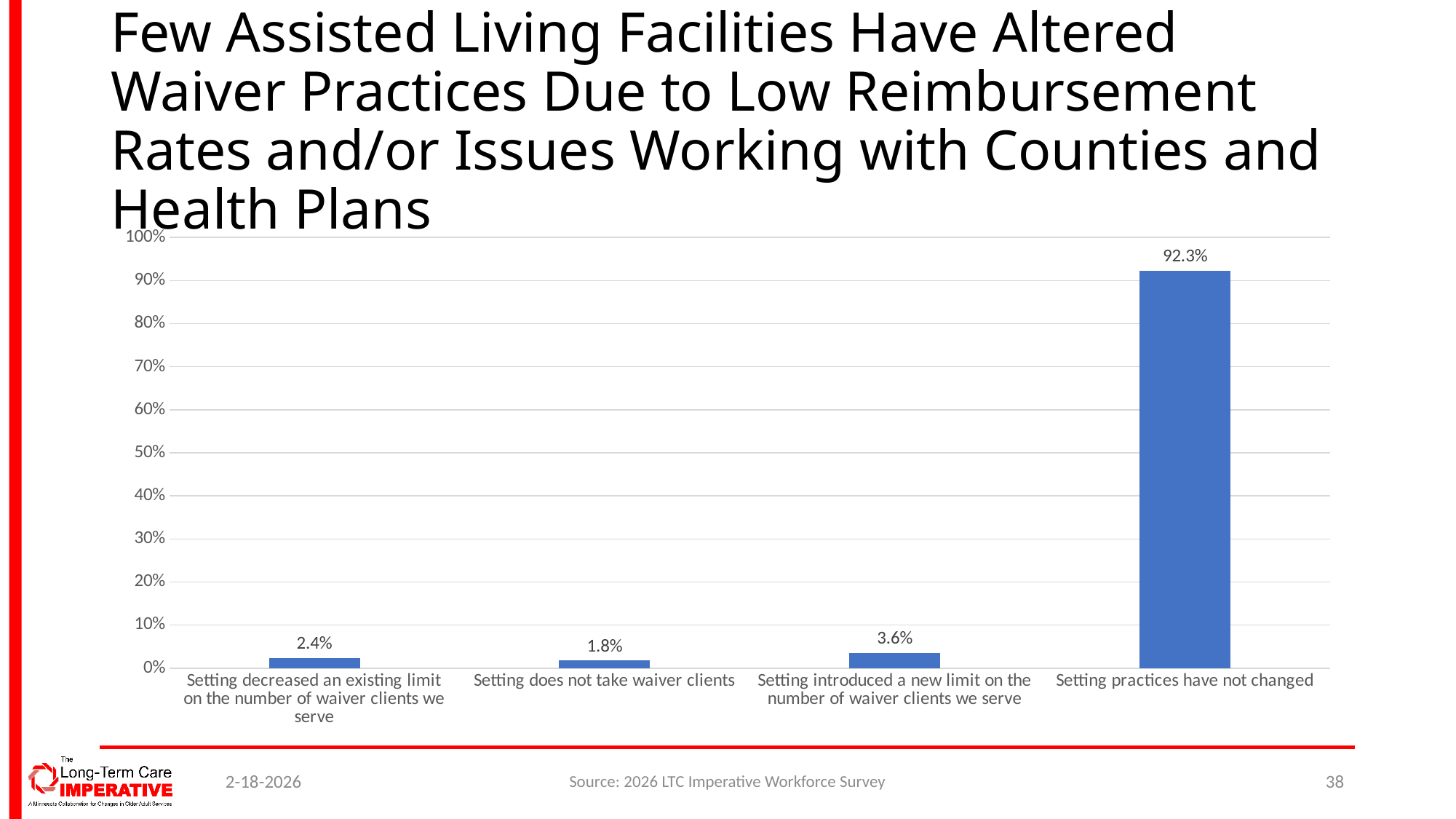
What percentage of assisted living facilities reported that setting practices have not changed? 92.3% Which is larger: the value for 'Setting decreased an existing limit on the number of waiver clients we serve' or 'Setting introduced a new limit on the number of waiver clients we serve'? Setting introduced a new limit on the number of waiver clients we serve Is the value for 'Setting practices have not changed' greater or less than 90%? greater What kind of chart is shown on the slide? Bar chart How many categories are shown on the chart? 4 What is the value for 'Setting introduced a new limit on the number of waiver clients we serve'? 3.6% What is the difference between the value for 'Setting introduced a new limit on the number of waiver clients we serve' and 'Setting does not take waiver clients'? 1.8% What is the value for 'Setting decreased an existing limit on the number of waiver clients we serve'? 2.4% What is the value for 'Setting does not take waiver clients'? 1.8% Which category has the lowest value? Setting does not take waiver clients What is the source cited for the chart data? 2026 LTC Imperative Workforce Survey Which category has the highest value? Setting practices have not changed